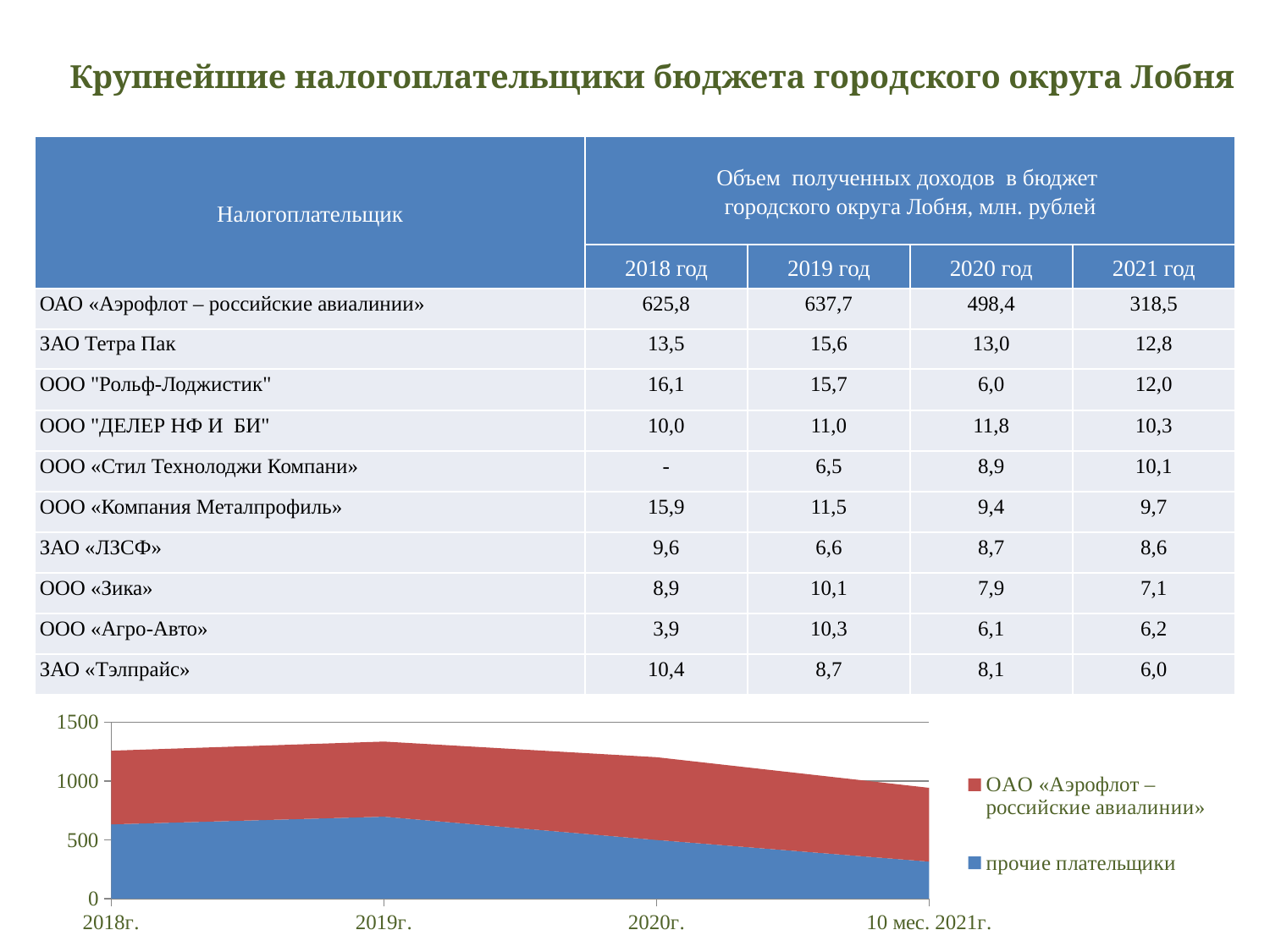
What kind of chart is shown at the bottom of the slide? stacked area chart How many points are there along the x axis of the chart? 4 Is the value of the bottom (blue) series for 10 мес. 2021г. greater or less than 500? less Is the total stacked value for 2018г. greater or less than 1000? greater What are the two series named in the chart legend? ОАО «Аэрофлот – российские авиалинии» and прочие плательщики How many series does the legend of the chart list? 2 What colour is the series «ОАО «Аэрофлот – российские авиалинии»» in the chart legend? red At which x-axis point is the total stacked value lowest? 10 мес. 2021г. Does the total stacked value rise or fall from 2019г. to 10 мес. 2021г.? fall Is the value of the bottom (blue) series for 2018г. greater or less than 500? greater Which is larger, the total stacked value for 2020г. or for 10 мес. 2021г.? 2020г.